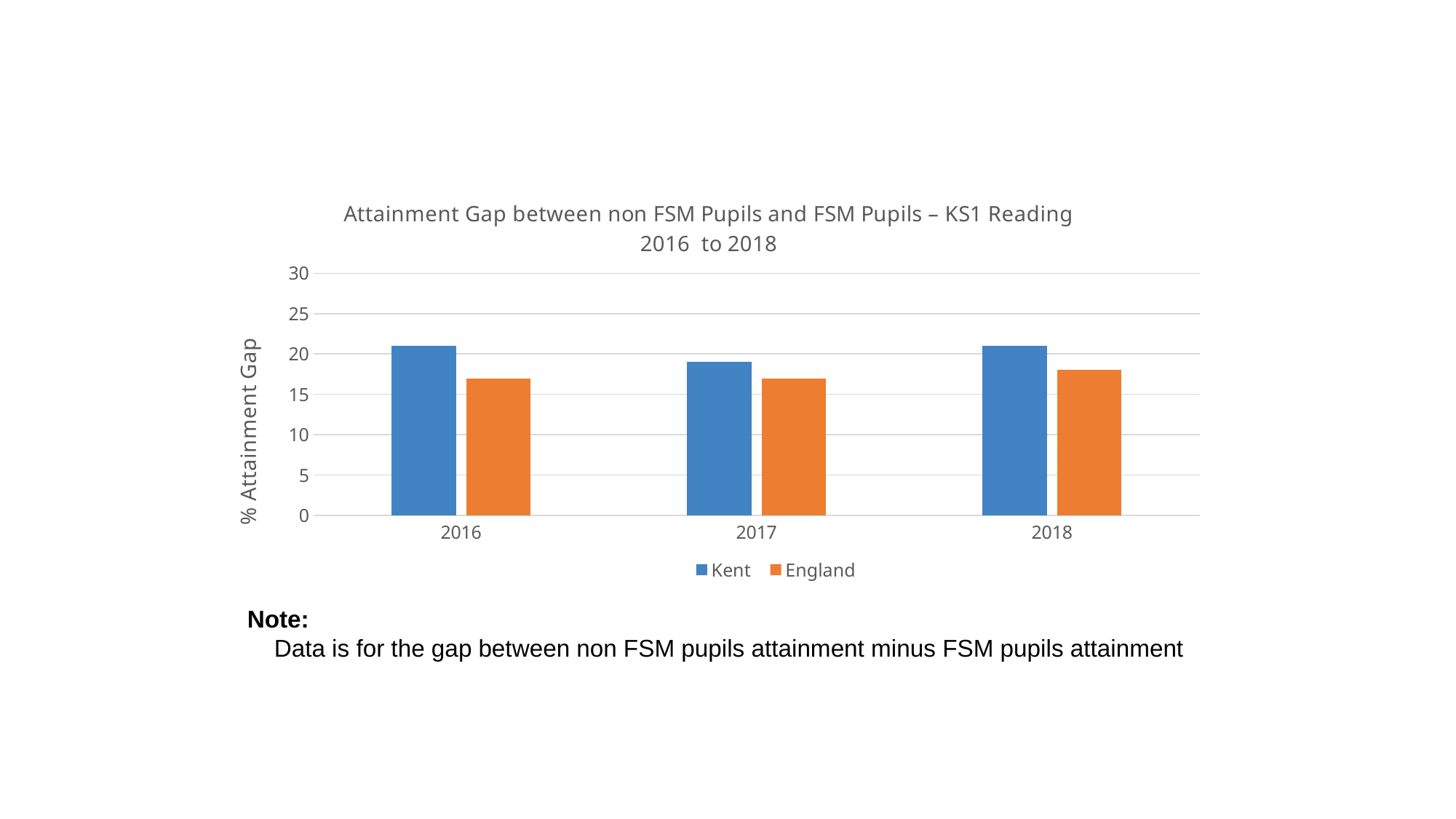
How many series does the legend list? 2 What kind of chart is shown on the slide? bar chart In which year is the Kent attainment gap lowest? 2017 How many years are shown on the x axis? 3 Which series has the larger attainment gap in 2017, Kent or England? Kent Is the value for England in 2016 greater or less than 20? less What is the label on the vertical axis? % Attainment Gap Is the value for England in 2018 greater or less than 15? greater Which colour represents England in the chart? orange Is the value for Kent in 2017 greater or less than 20? less Which series has the larger attainment gap in 2016, Kent or England? Kent Which series has the larger attainment gap in 2018, Kent or England? Kent